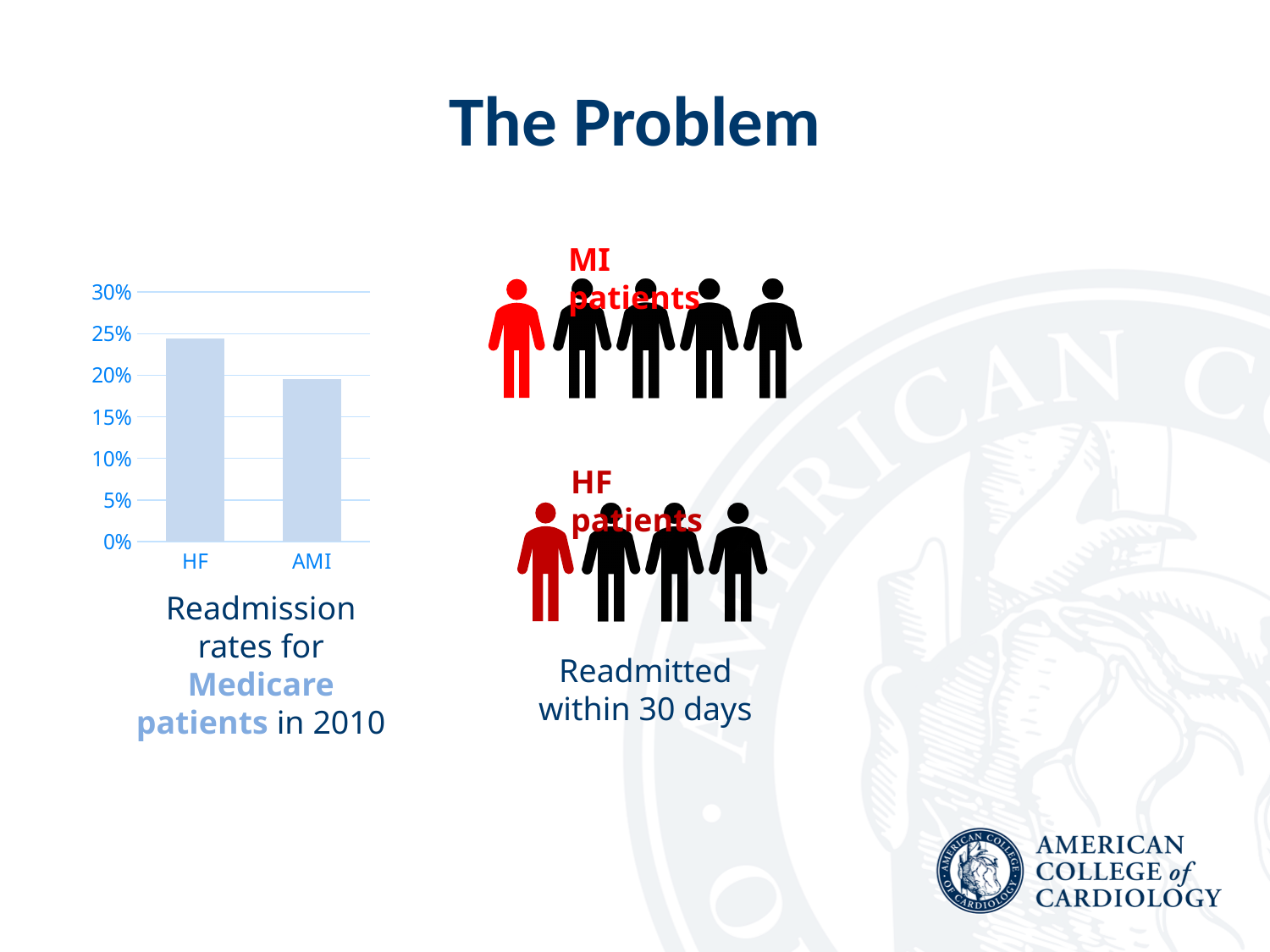
Is the value for HF in the bar chart greater or less than 30%? less Is the value for AMI in the bar chart greater or less than 15%? greater How many categories are shown on the x axis of the bar chart? 2 Do the values in the bar chart rise or fall from HF to AMI? fall Is the value for HF in the bar chart greater or less than 20%? greater What kind of chart is shown on the left of the slide? bar chart Which category has the highest readmission rate in the bar chart? HF In the bar chart, which is larger, the value for HF or the value for AMI? HF What is the highest value shown on the y axis of the bar chart? 30% According to the caption under the bar chart, what year do the readmission rates refer to? 2010 Which category has the lowest readmission rate in the bar chart? AMI